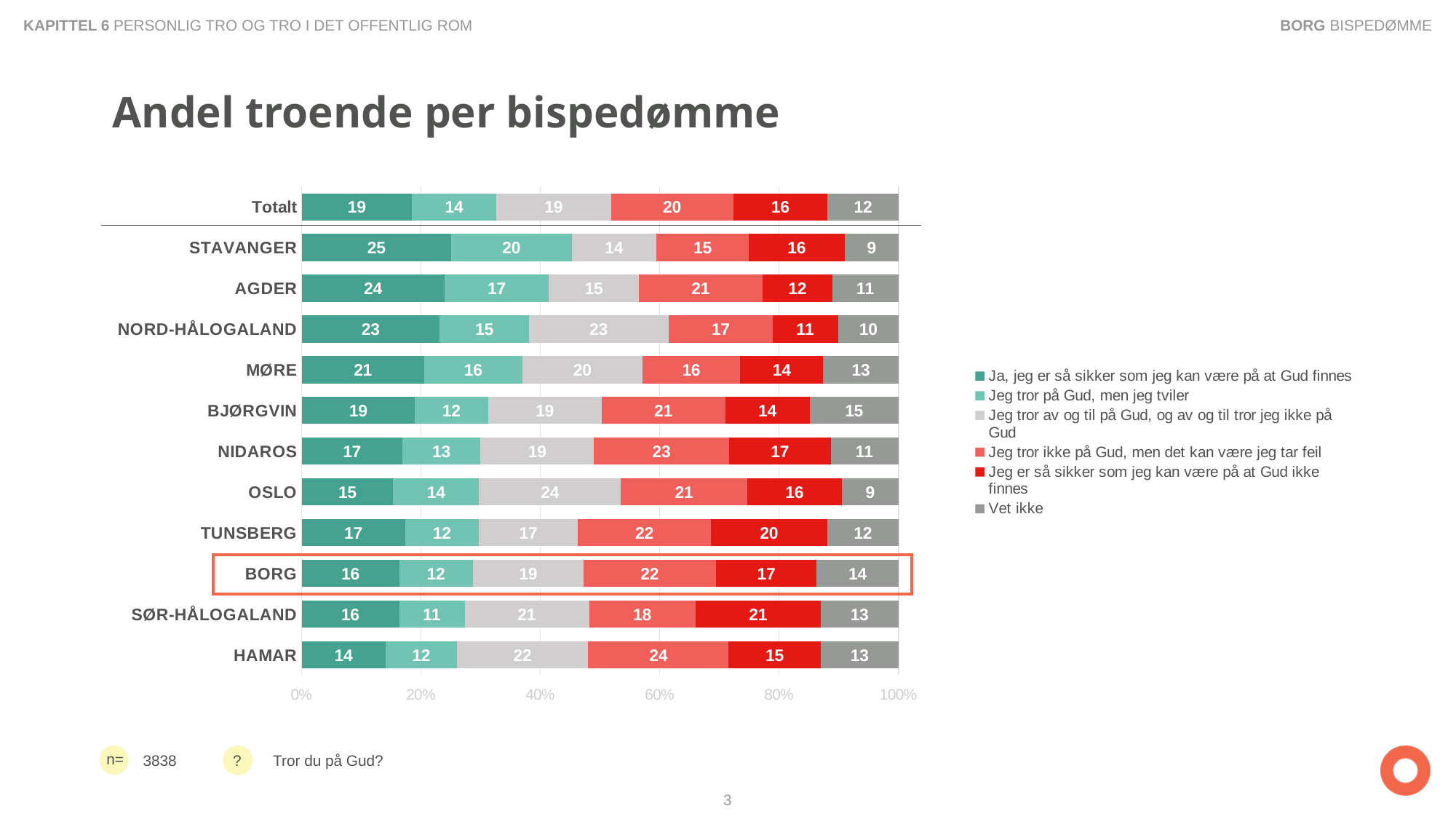
Which has the larger value for 'Jeg tror av og til på Gud, og av og til tror jeg ikke på Gud': OSLO or STAVANGER? OSLO Which diocese has the lowest value for 'Ja, jeg er så sikker som jeg kan være på at Gud finnes'? HAMAR Which diocese has the highest value for 'Jeg er så sikker som jeg kan være på at Gud ikke finnes'? SØR-HÅLOGALAND How many series does the legend list? 6 What is the total of the stacked bar for BORG? 100 What is the difference between STAVANGER and HAMAR in the series 'Ja, jeg er så sikker som jeg kan være på at Gud finnes'? 11 What is the 'Vet ikke' value for Totalt? 12 What type of chart is shown on the slide? Stacked bar chart What is the value for STAVANGER in the series 'Ja, jeg er så sikker som jeg kan være på at Gud finnes'? 25 What is the value for BORG in the series 'Jeg tror ikke på Gud, men det kan være jeg tar feil'? 22 How many rows (categories) are plotted in the chart, including Totalt? 12 Which diocese has the highest value for 'Ja, jeg er så sikker som jeg kan være på at Gud finnes'? STAVANGER